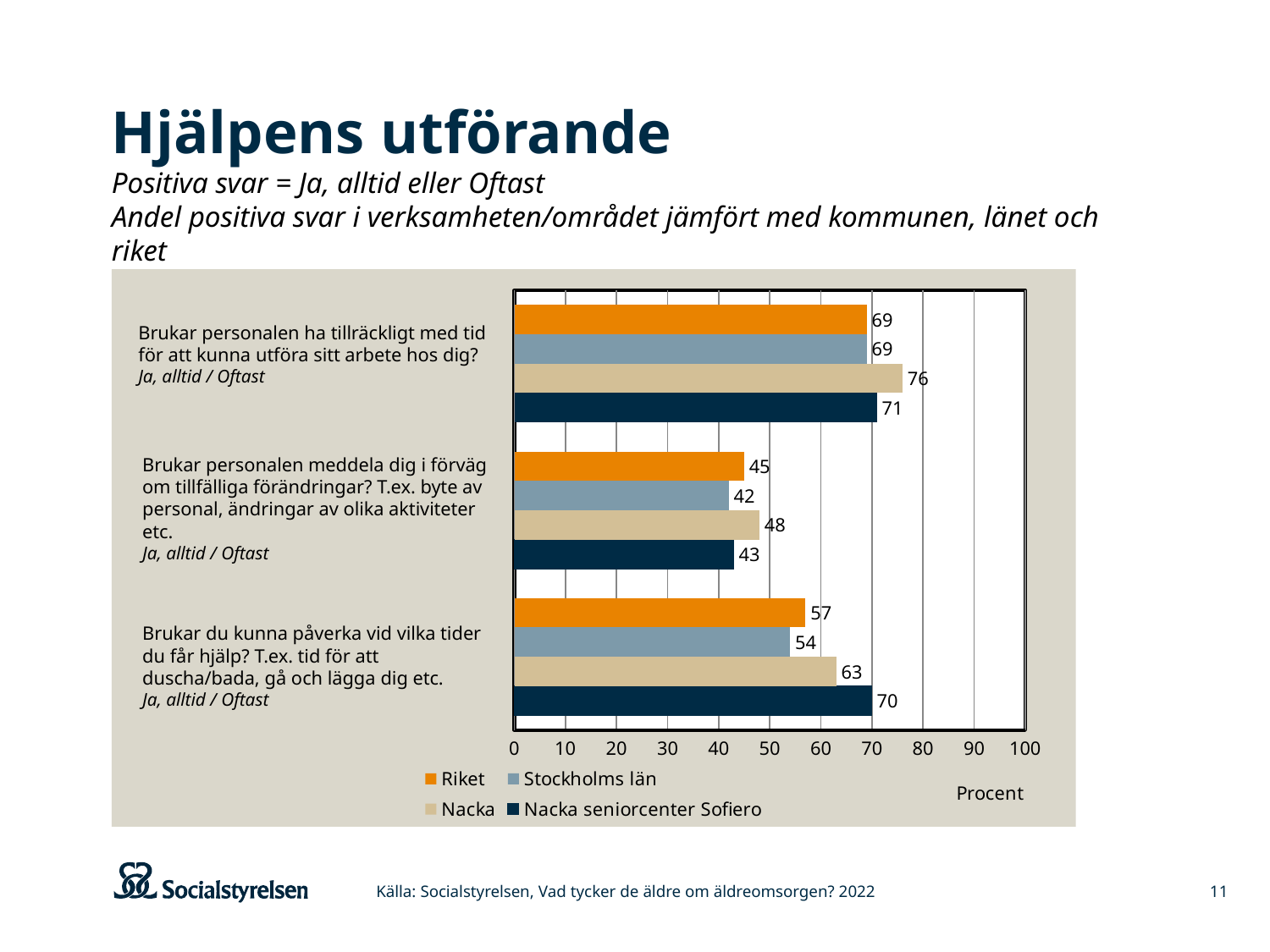
What is the label on the horizontal axis of the chart? Procent What is the value for Nacka on the question "Brukar personalen ha tillräckligt med tid för att kunna utföra sitt arbete hos dig?"? 76 Which series has the highest value on the question "Brukar personalen meddela dig i förväg om tillfälliga förändringar?"? Nacka What is the value for Stockholms län on the question "Brukar personalen meddela dig i förväg om tillfälliga förändringar?"? 42 How many series does the legend list? 4 How many question categories are shown in the chart? 3 Which series has the lowest value on the question "Brukar du kunna påverka vid vilka tider du får hjälp?"? Stockholms län Which is larger on the question "Brukar personalen ha tillräckligt med tid för att kunna utföra sitt arbete hos dig?": Nacka or Nacka seniorcenter Sofiero? Nacka What is the value for Nacka seniorcenter Sofiero on the question "Brukar du kunna påverka vid vilka tider du får hjälp?"? 70 What is the difference between Nacka seniorcenter Sofiero and Riket on the question "Brukar du kunna påverka vid vilka tider du får hjälp?"? 13 Is the value for Riket on the question "Brukar personalen meddela dig i förväg om tillfälliga förändringar?" greater or less than 50? less What kind of chart is shown on the slide? bar chart